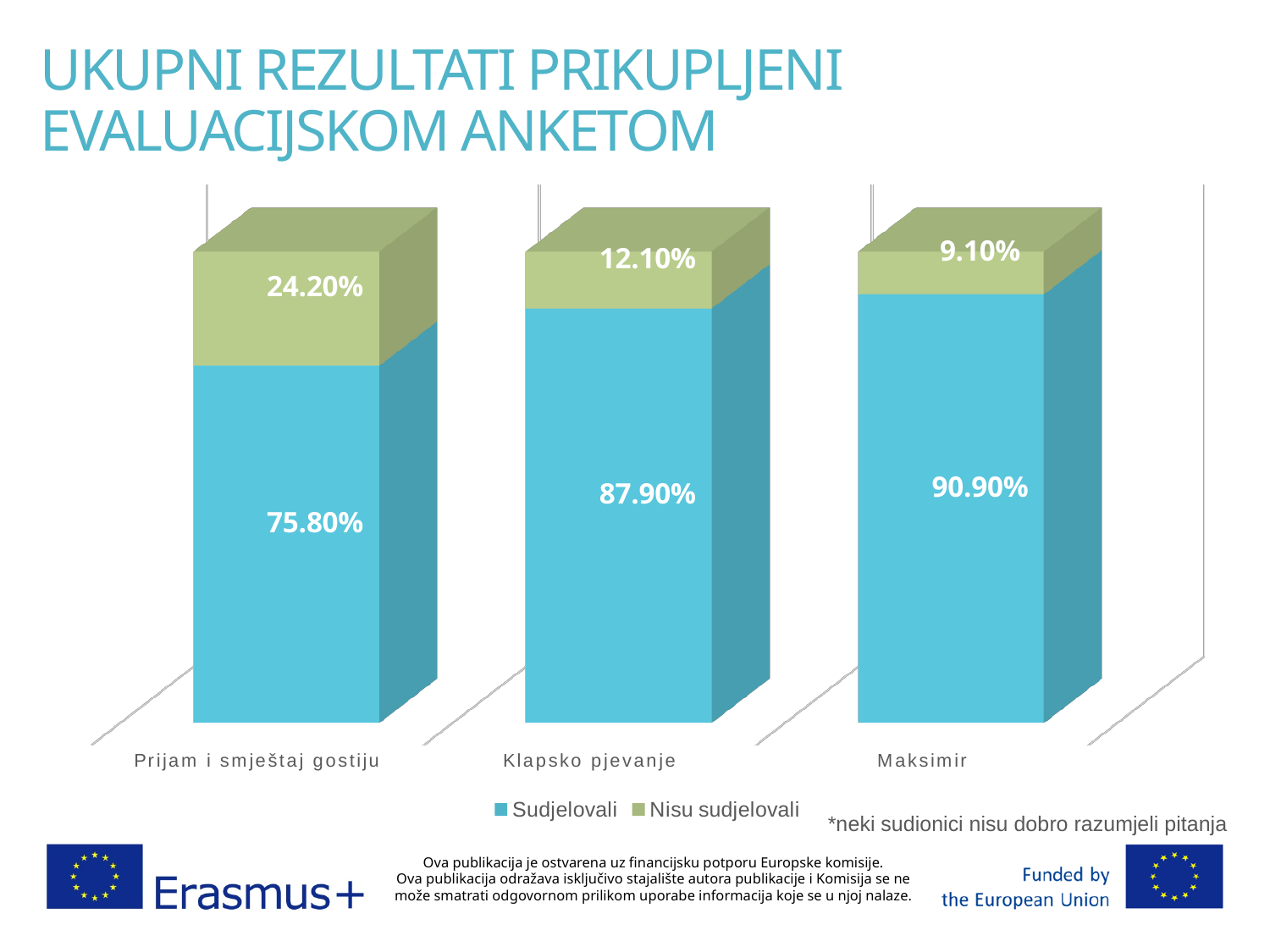
Which category has the lowest 'Nisu sudjelovali' value? Maksimir Which is larger: the 'Nisu sudjelovali' value for Klapsko pjevanje or for Maksimir? Klapsko pjevanje What is the difference between the 'Sudjelovali' values for Maksimir and Prijam i smještaj gostiju? 15.10% Which series is shown in blue in the legend? Sudjelovali Which category has the highest 'Sudjelovali' value? Maksimir What is the 'Sudjelovali' value for Klapsko pjevanje? 87.90% What is the 'Sudjelovali' value for Maksimir? 90.90% How many categories are shown on the x axis? 3 What kind of chart is shown on the slide? Stacked bar chart What is the 'Nisu sudjelovali' value for Prijam i smještaj gostiju? 24.20% What is the total of the stacked bar for Klapsko pjevanje? 100.00% How many series does the legend list? 2